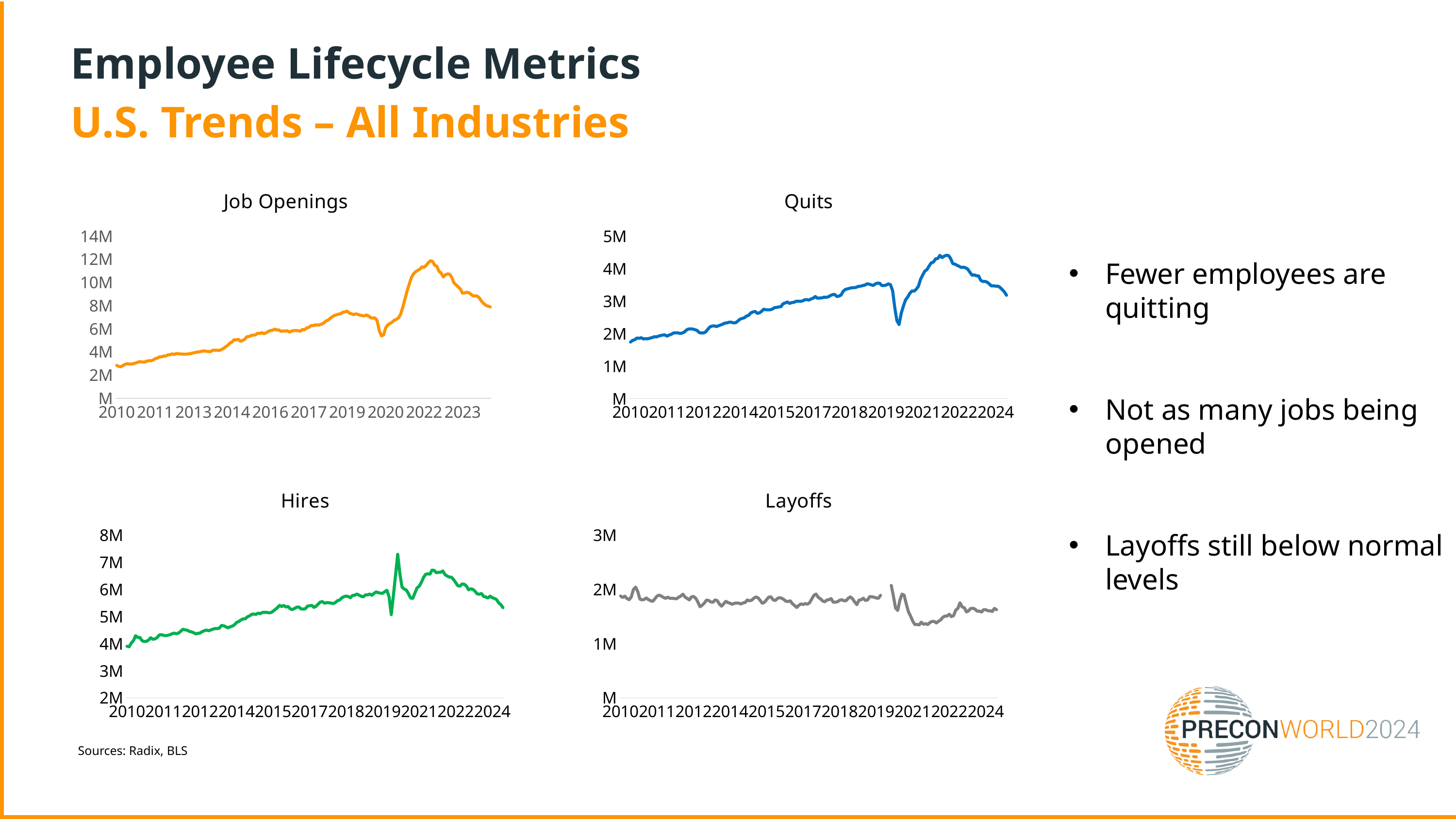
What kind of chart is the Job Openings chart? line chart In the Layoffs chart, is the highest value on the line greater or less than 3M? less In the Hires chart, do the values rise or fall from 2022 to 2024? fall In the Job Openings chart, is the peak value reached around 2022 greater or less than 10M? greater In the Quits chart, is the value at the sharp dip in 2020 greater or less than 3M? less In the Job Openings chart, do the values rise or fall from 2022 to 2023? fall In the Quits chart, do the values generally rise or fall from 2010 to 2019? rise What colour is the line in the Hires chart? green How many charts are shown on the slide? 4